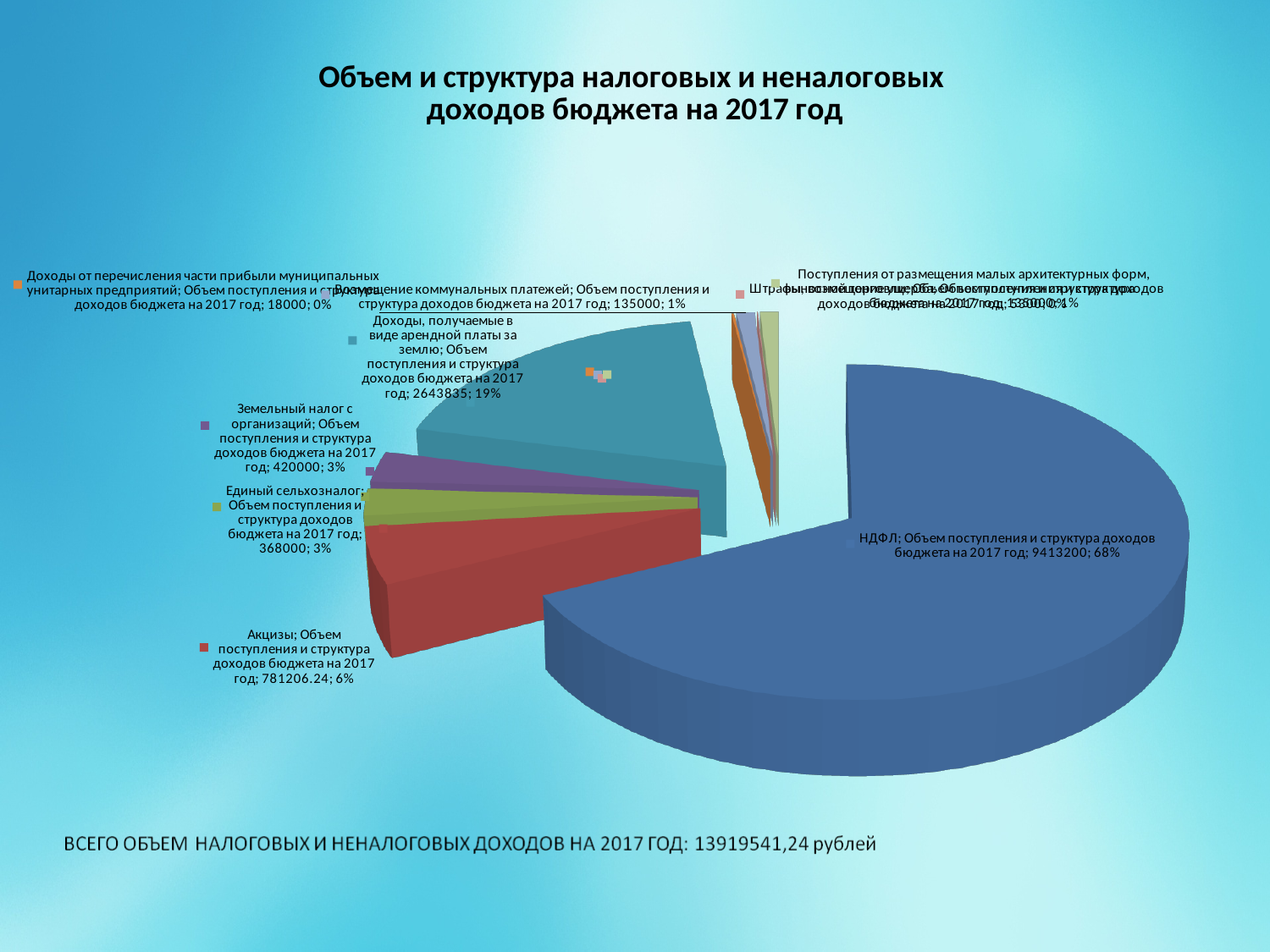
What share of the pie does Доходы, получаемые в виде арендной платы за землю represent? 19% What is the value for НДФЛ? 9413200 Which category has the largest slice of the pie? НДФЛ What is the value for Акцизы? 781206.24 What is the value for Единый сельхозналог? 368000 What is the value for Доходы, получаемые в виде арендной платы за землю? 2643835 What is the title of the chart? Объем и структура налоговых и неналоговых доходов бюджета на 2017 год What is the difference between the values for Земельный налог с организаций and Единый сельхозналог? 52000 Which is larger, Земельный налог с организаций or Единый сельхозналог? Земельный налог с организаций What share of the pie does НДФЛ represent? 68% What is the value for Возмещение коммунальных платежей? 135000 What kind of chart is shown on the slide? pie chart